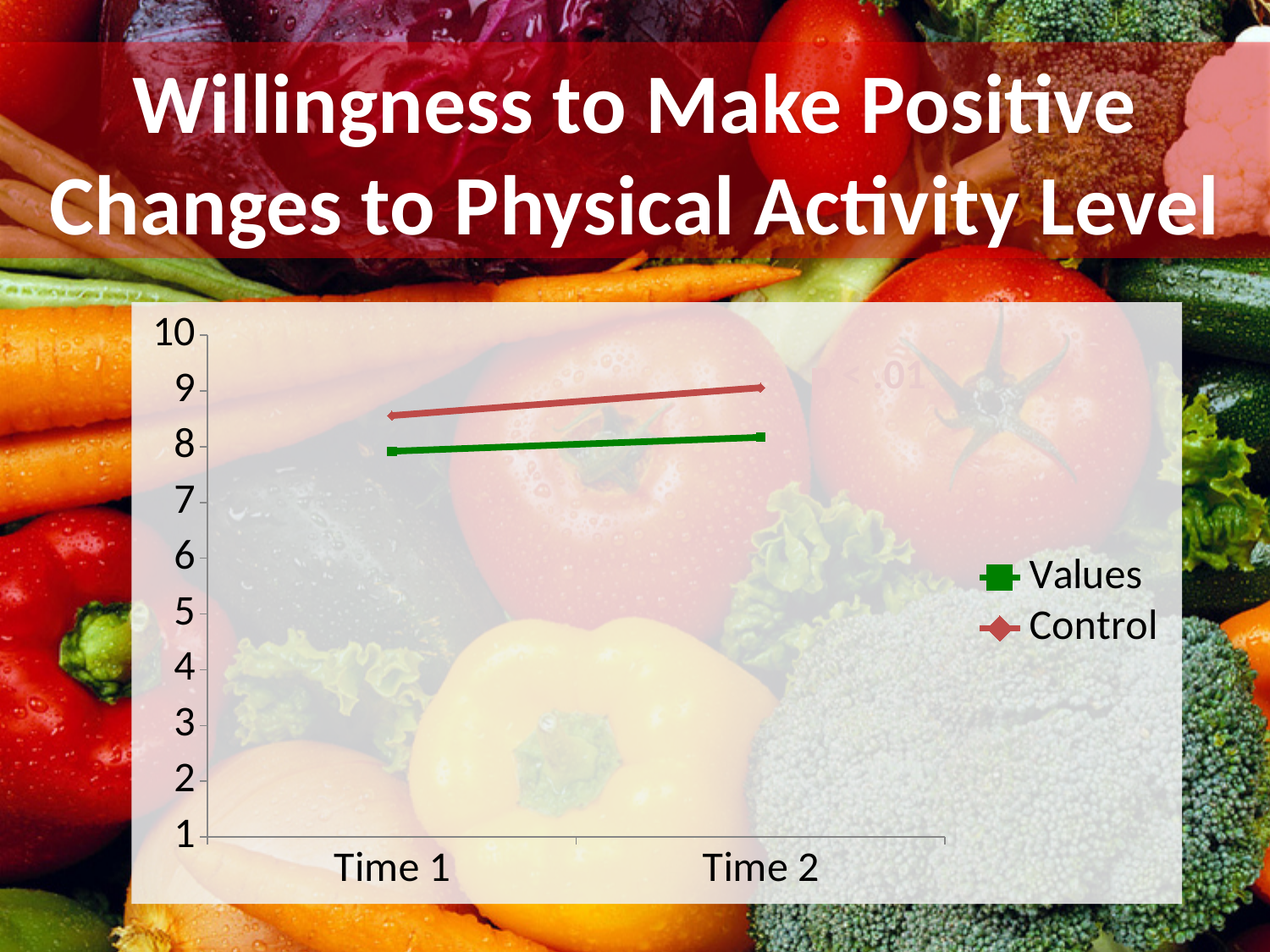
What colour is the Control series line? red Is the Control value at Time 1 greater or less than 8? greater At Time 1, which series has the lower value, Values or Control? Values What is the title of the slide containing the chart? Willingness to Make Positive Changes to Physical Activity Level Is the Control value at Time 1 greater or less than 9? less What kind of chart is shown on the slide? line chart Does the Control line rise or fall from Time 1 to Time 2? rise Does the Values line rise or fall from Time 1 to Time 2? rise At Time 2, which series has the higher value, Values or Control? Control Is the Values value at Time 2 greater or less than 9? less How many series does the legend list? 2 How many time points are plotted on the x axis? 2